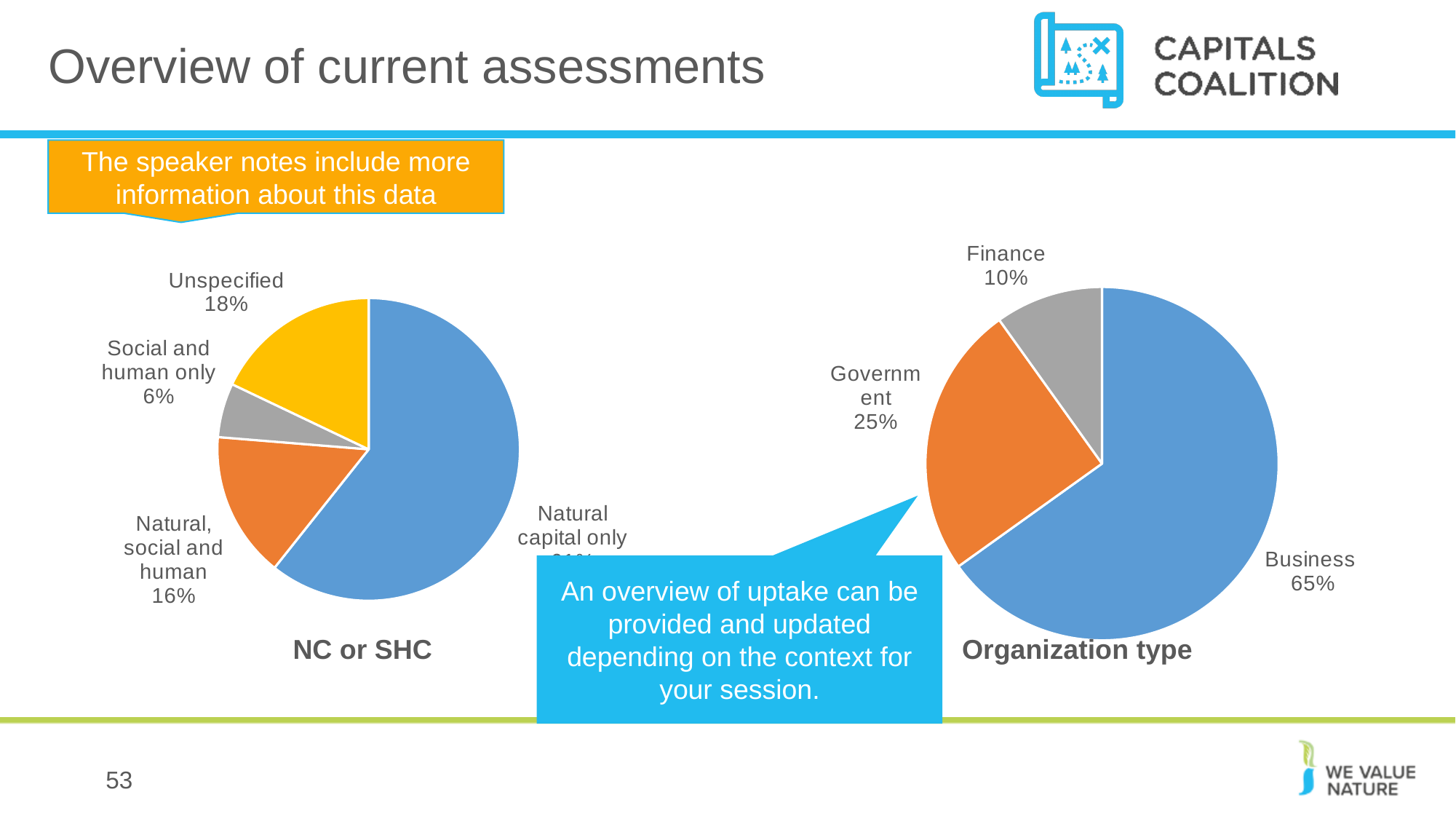
In the 'Organization type' chart, what percentage is 'Business'? 65% In the 'NC or SHC' chart, which category has the smallest slice? Social and human only What kind of chart is the 'NC or SHC' chart? Pie chart In the 'Organization type' chart, how many categories are shown? 3 In the 'NC or SHC' chart, what is the difference between 'Unspecified' and 'Social and human only'? 12% In the 'Organization type' chart, which category has the smallest share? Finance In the 'Organization type' chart, what percentage is 'Government'? 25% In the 'NC or SHC' chart, what percentage is 'Social and human only'? 6% In the 'NC or SHC' chart, what percentage is 'Natural, social and human'? 16% In the 'Organization type' chart, what is the difference between 'Business' and 'Government'? 40% In the 'NC or SHC' chart, which category has the largest slice? Natural capital only In the 'NC or SHC' chart, what percentage is labelled 'Unspecified'? 18%